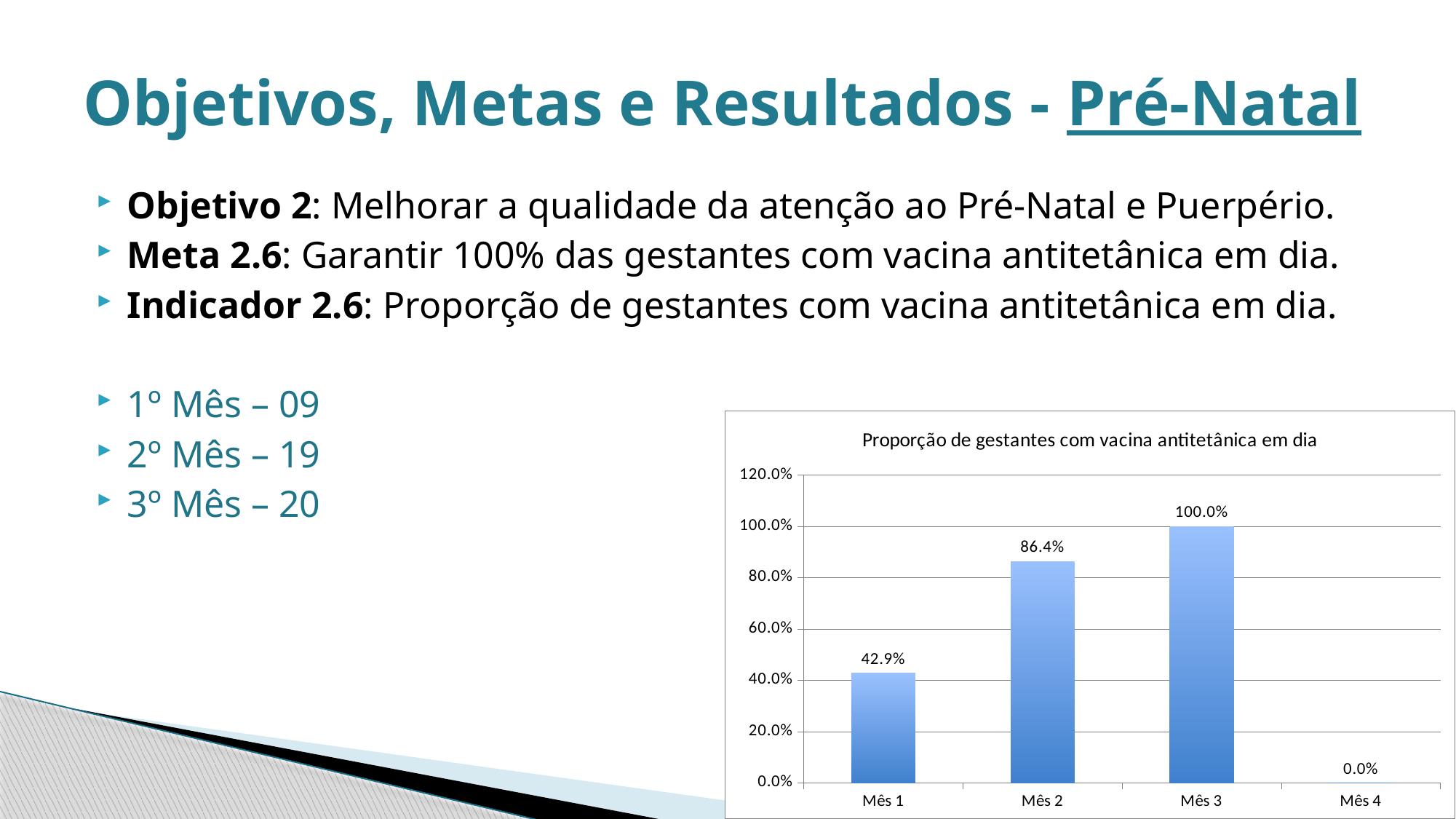
What is the value for Mês 2? 86.4% What is the difference between the values for Mês 2 and Mês 1? 43.5% What is the title of the chart? Proporção de gestantes com vacina antitetânica em dia What is the value for Mês 3? 100.0% What kind of chart is shown on the slide? bar chart How many months are shown on the x axis of the chart? 4 What is the value for Mês 4? 0.0% Which month has the lowest value? Mês 4 What is the value for Mês 1? 42.9% Which month has the highest value? Mês 3 Which is larger, the value for Mês 2 or the value for Mês 1? Mês 2 What is the difference between the values for Mês 3 and Mês 1? 57.1%